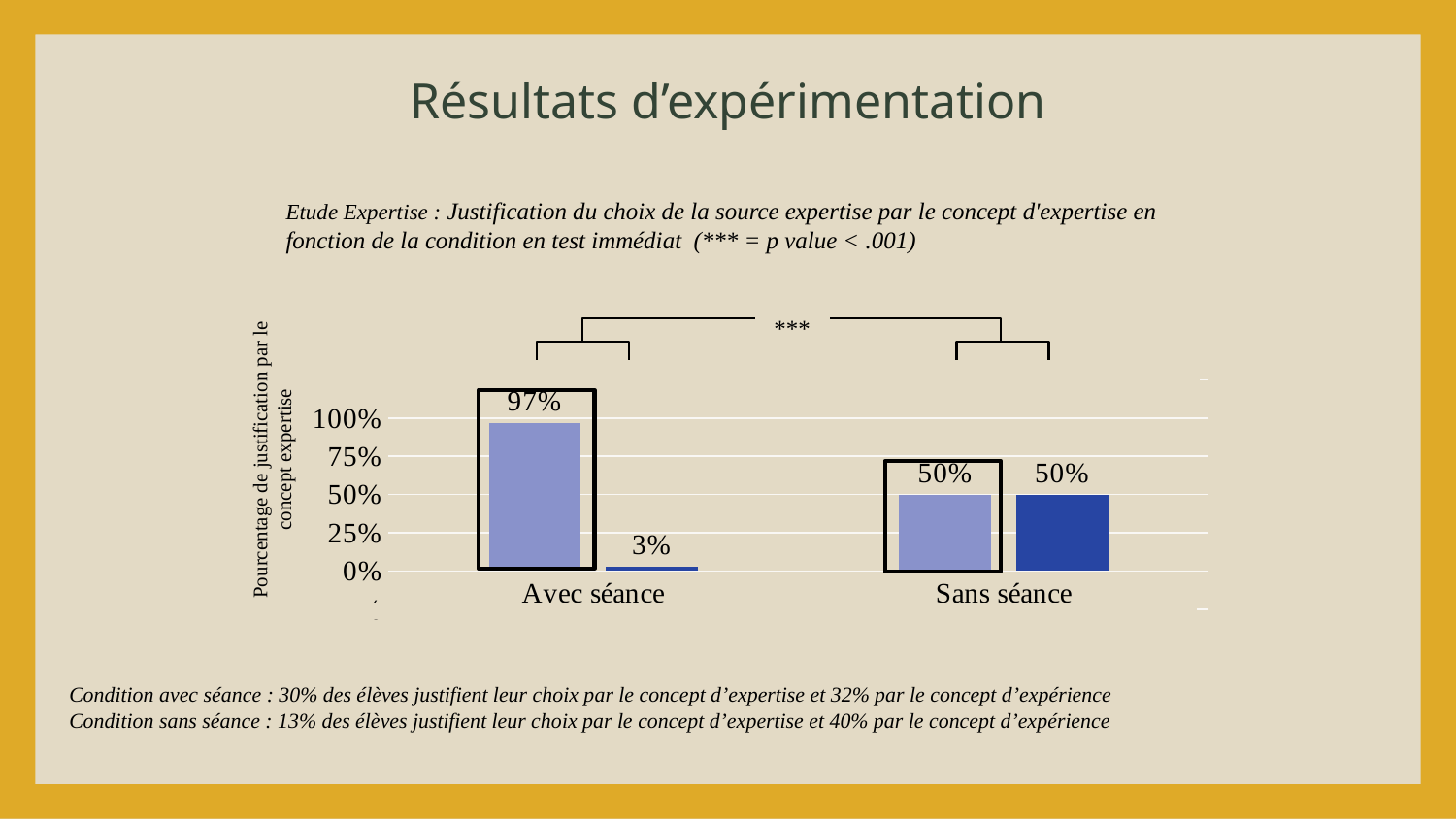
What is the value of the light blue bar for "Sans séance"? 50% Which is larger: the light blue bar for "Avec séance" or the light blue bar for "Sans séance"? Avec séance What is the value of the dark blue bar for "Sans séance"? 50% What is the value of the light blue bar for "Avec séance"? 97% What is the difference between the light blue and dark blue bars for "Avec séance"? 94% How many categories are shown on the x axis of the chart? 2 What type of chart is shown on the slide? bar chart Which bar in the chart has the lowest value? the dark blue bar for Avec séance (3%) What is the highest tick value shown on the y axis of the chart? 100% What is the label of the y axis of the chart? Pourcentage de justification par le concept expertise Which bar in the chart has the highest value? the light blue bar for Avec séance (97%) What is the value of the dark blue bar for "Avec séance"? 3%